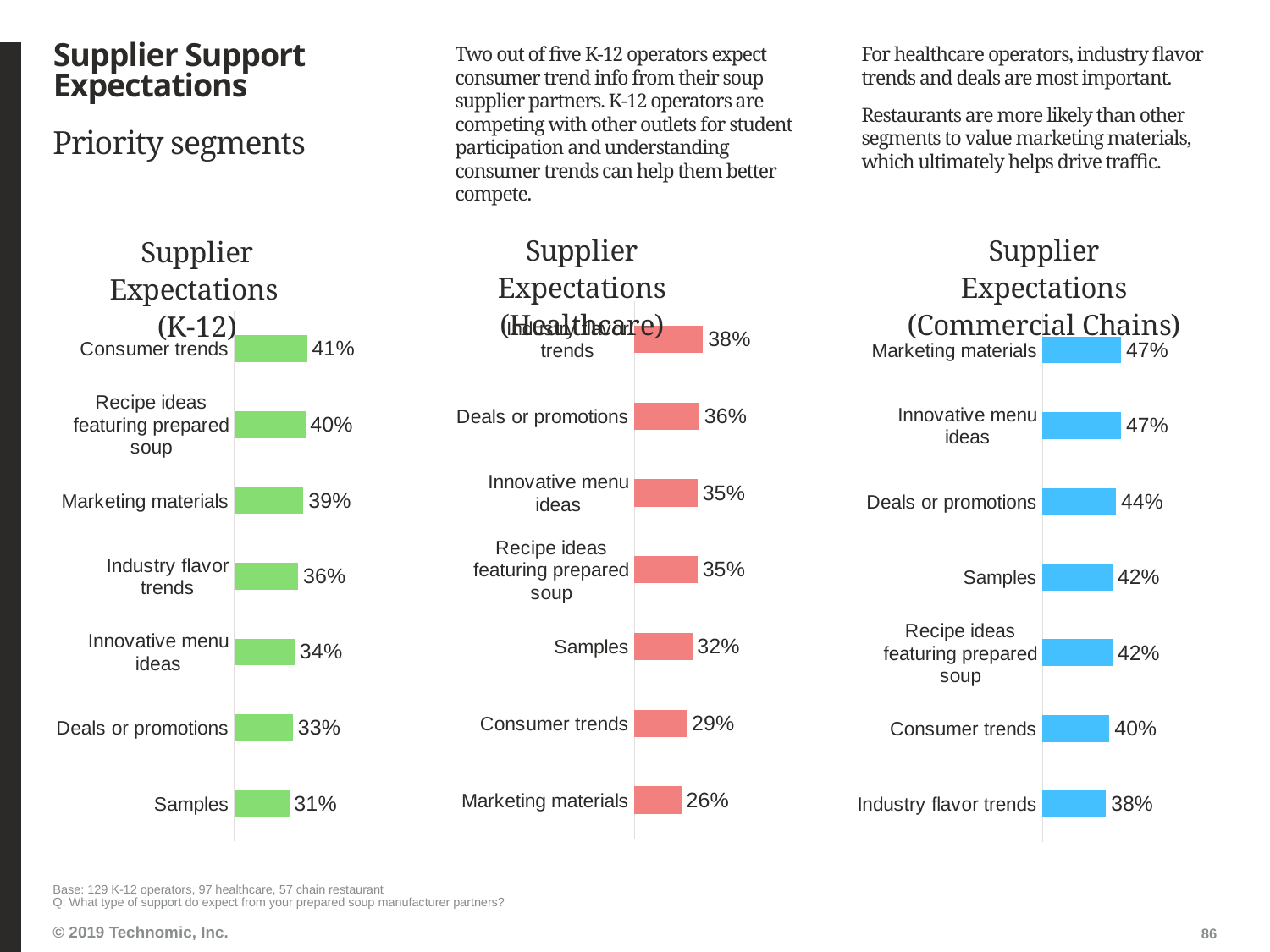
In the Supplier Expectations (K-12) chart, what is the difference between Consumer trends and Samples? 10% In the Supplier Expectations (K-12) chart, which category has the lowest value? Samples In the Supplier Expectations (Commercial Chains) chart, which category has the lowest value? Industry flavor trends In the Supplier Expectations (Healthcare) chart, what is the value for Deals or promotions? 36% In the Supplier Expectations (K-12) chart, what is the value for Marketing materials? 39% In the Supplier Expectations (Healthcare) chart, which is larger, Samples or Consumer trends? Samples In the Supplier Expectations (Commercial Chains) chart, what is the value for Deals or promotions? 44% In the Supplier Expectations (Commercial Chains) chart, what is the difference between Marketing materials and Consumer trends? 7% What type of chart is the Supplier Expectations (Healthcare) chart? Bar chart In the Supplier Expectations (Healthcare) chart, which category has the lowest value? Marketing materials In the Supplier Expectations (K-12) chart, which category has the highest value? Consumer trends How many categories are shown in the Supplier Expectations (K-12) chart? 7